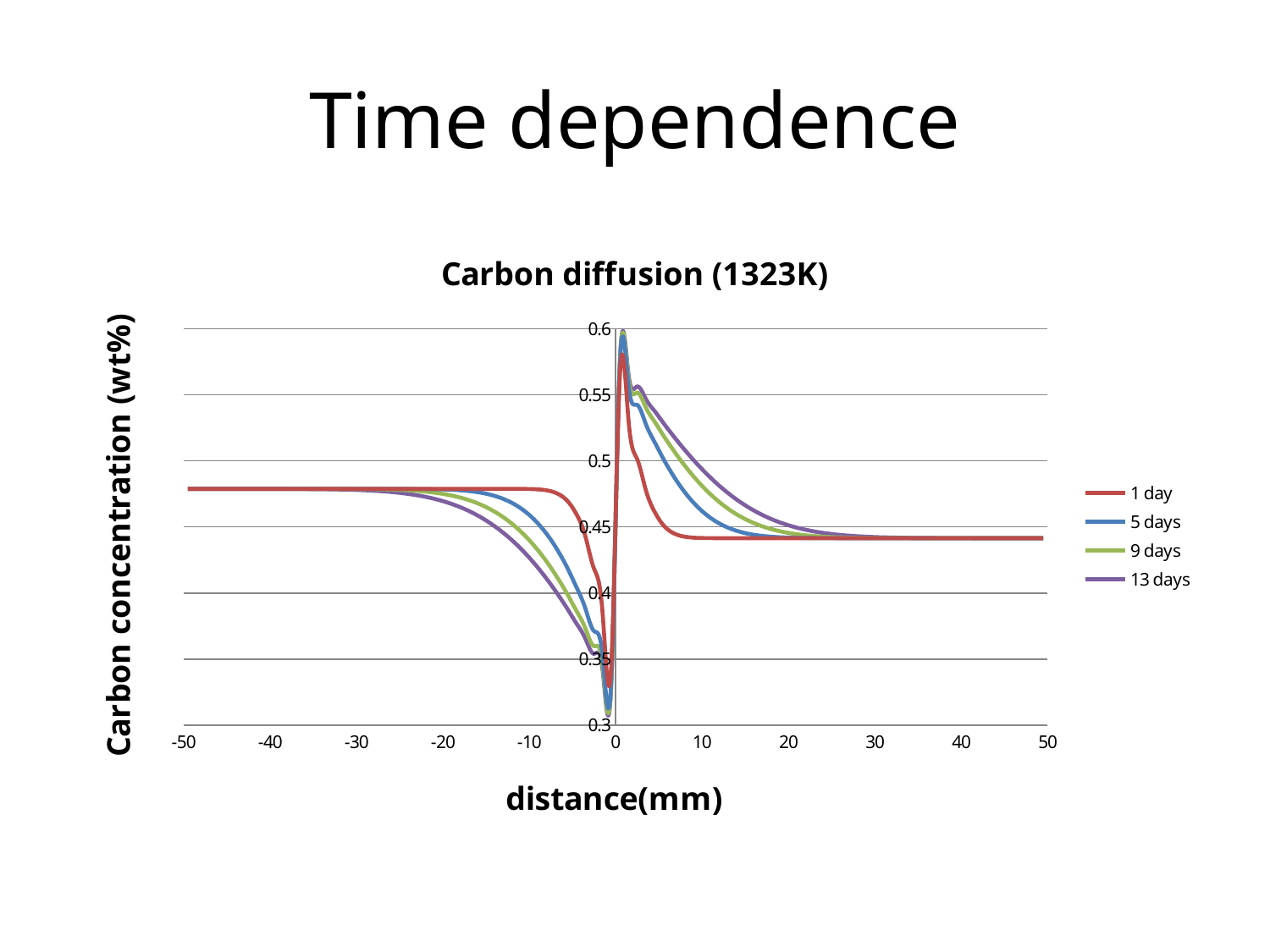
At a distance of 10 mm, is the 13 days curve greater or less than 0.45? greater At a distance of -10 mm, which series has the higher carbon concentration, 1 day or 13 days? 1 day What kind of chart is shown on the slide? line chart At a distance of 40 mm, is the carbon concentration greater or less than 0.5? less What is the label of the x axis of the chart? distance(mm) At a distance of -10 mm, is the 13 days curve greater or less than 0.5? less What is the title of the chart? Carbon diffusion (1323K) What is the highest value shown on the y axis of the chart? 0.6 Between distances of 10 mm and 30 mm, does the 13 days curve rise or fall? fall At a distance of 10 mm, which series has the higher carbon concentration, 1 day or 13 days? 13 days How many series does the legend of the 'Carbon diffusion (1323K)' chart list? 4